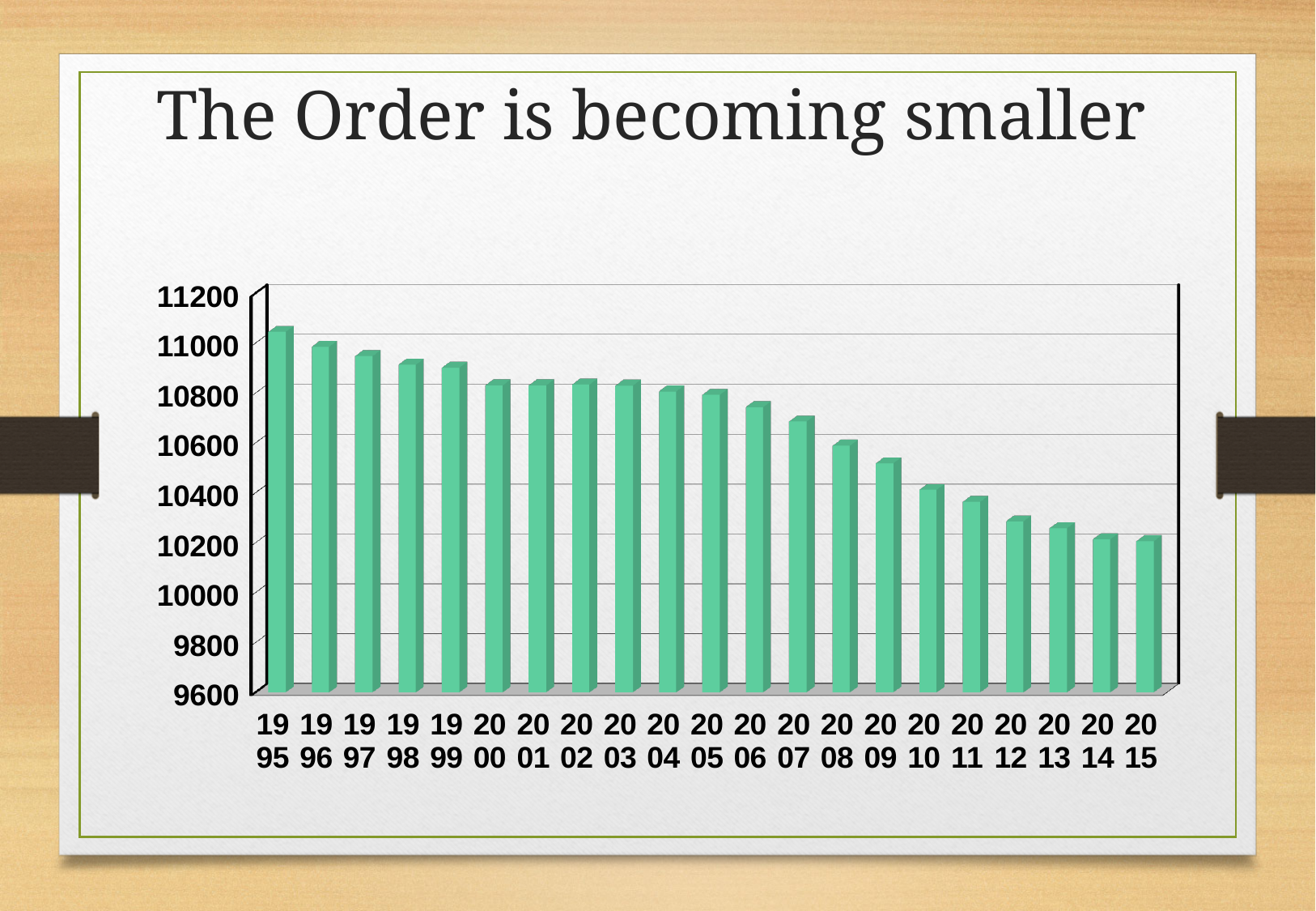
Is the value for 2015 greater or less than 10400? less Which year has the highest bar in the chart? 1995 What is the title of the slide containing the chart? The Order is becoming smaller How many years are plotted on the x axis of the chart? 21 Is the value for 2008 greater or less than 10800? less Which is larger, the value for 2000 or the value for 2010? 2000 Is the value for 1995 greater or less than 10800? greater What kind of chart is shown on the slide? bar chart Which is larger, the value for 1995 or the value for 2015? 1995 Do the values rise or fall from 1995 to 2015? fall